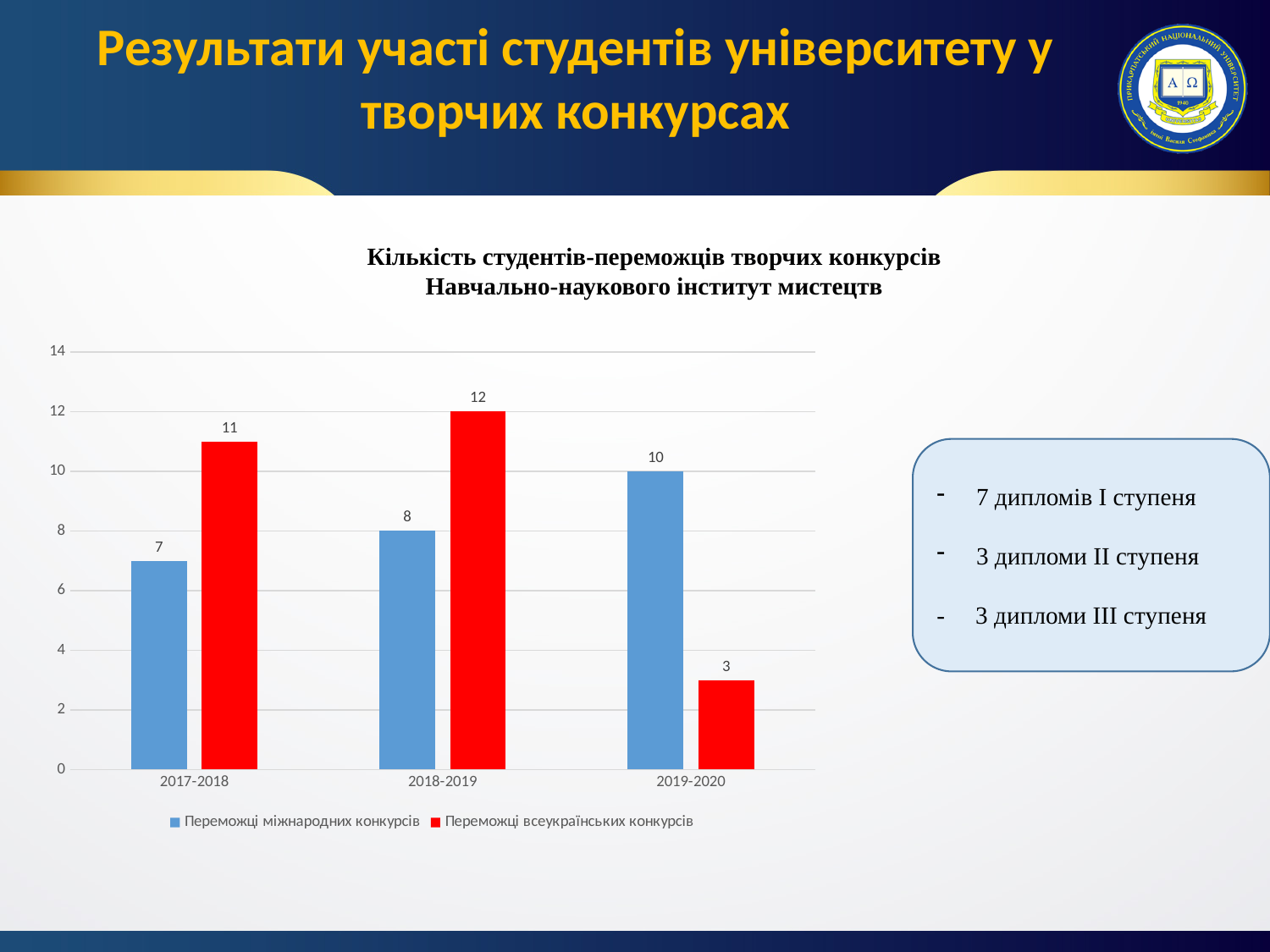
What colour are the bars for Переможці всеукраїнських конкурсів? Red How many series does the legend list? 2 What is the difference between Переможці всеукраїнських конкурсів and Переможці міжнародних конкурсів in 2017-2018? 4 What is the value for Переможці всеукраїнських конкурсів in 2018-2019? 12 What kind of chart is shown on the slide? Bar chart In which period is the value for Переможці міжнародних конкурсів highest? 2019-2020 In which period is the value for Переможці всеукраїнських конкурсів lowest? 2019-2020 How many periods are shown on the x axis? 3 What is the value for Переможці міжнародних конкурсів in 2017-2018? 7 Which is larger in 2019-2020: Переможці міжнародних конкурсів or Переможці всеукраїнських конкурсів? Переможці міжнародних конкурсів What is the value for Переможці всеукраїнських конкурсів in 2019-2020? 3 Do the values for Переможці міжнародних конкурсів rise or fall from 2017-2018 to 2019-2020? Rise